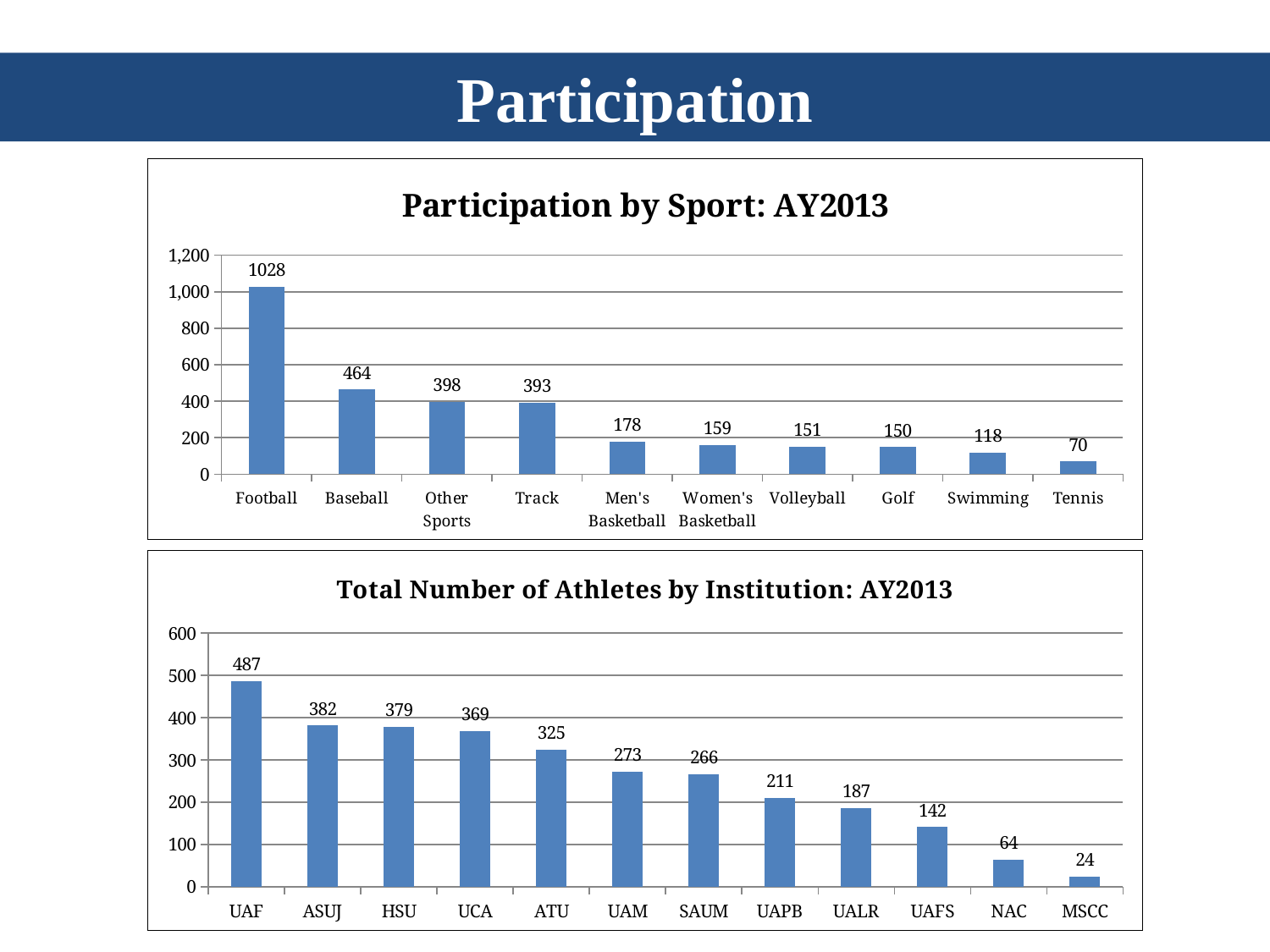
In the 'Total Number of Athletes by Institution: AY2013' chart, how many institutions are shown? 12 In the 'Participation by Sport: AY2013' chart, what is the difference between Baseball and Track? 71 What type of chart is the 'Total Number of Athletes by Institution: AY2013' chart? Bar chart In the 'Participation by Sport: AY2013' chart, how many sport categories are shown? 10 In the 'Total Number of Athletes by Institution: AY2013' chart, what is the value for UAPB? 211 In the 'Participation by Sport: AY2013' chart, what is the value for Swimming? 118 In the 'Total Number of Athletes by Institution: AY2013' chart, what is the difference between UAF and ASUJ? 105 In the 'Total Number of Athletes by Institution: AY2013' chart, do the values rise or fall from left to right? Fall In the 'Total Number of Athletes by Institution: AY2013' chart, which institution has the highest number of athletes? UAF In the 'Participation by Sport: AY2013' chart, which sport has the lowest participation? Tennis In the 'Participation by Sport: AY2013' chart, what is the value for Football? 1028 In the 'Participation by Sport: AY2013' chart, which is larger, Men's Basketball or Women's Basketball? Men's Basketball